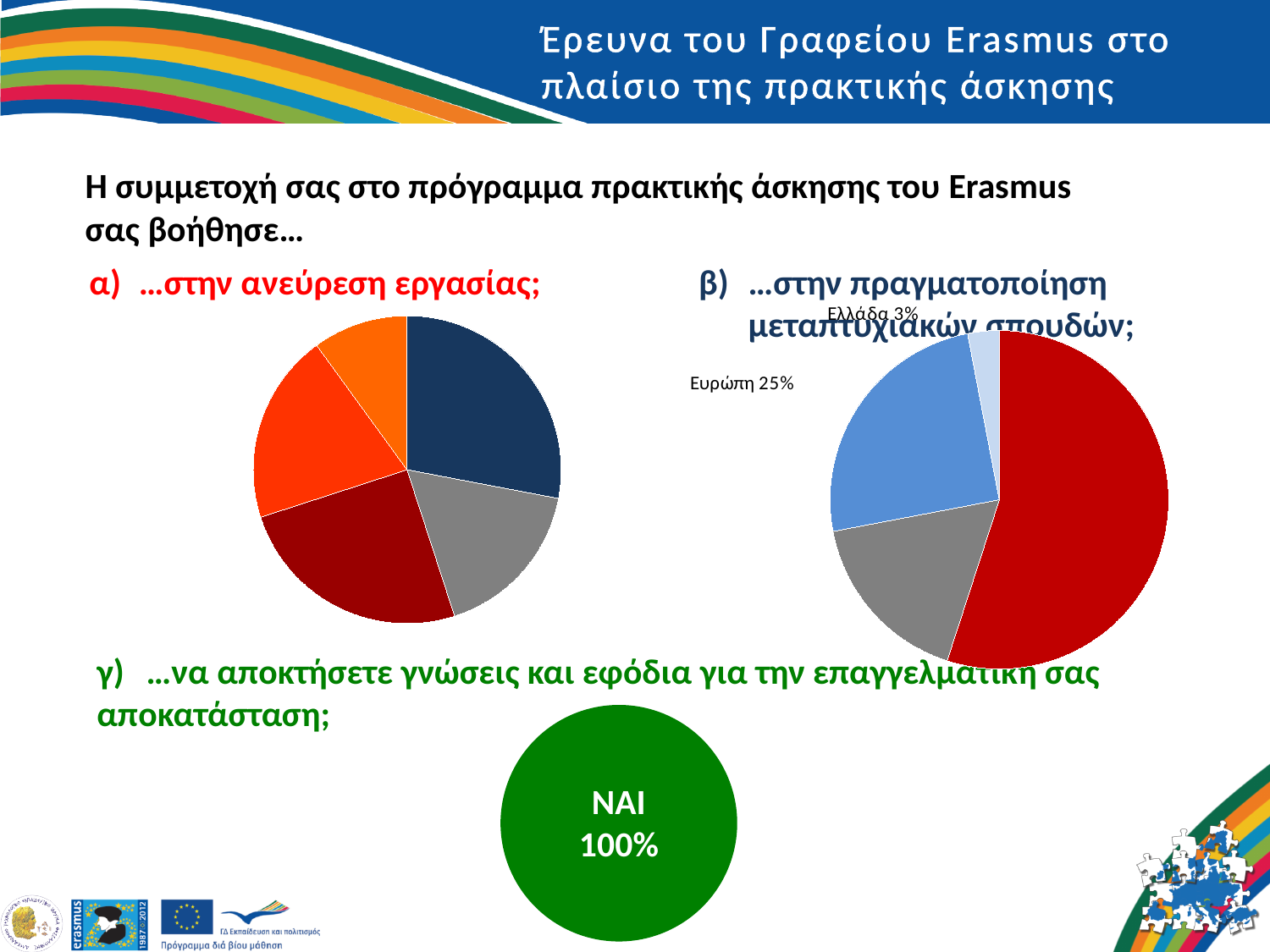
How many slices does the pie chart under "α) …στην ανεύρεση εργασίας;" have? 5 In the pie chart under "β) …στην πραγματοποίηση μεταπτυχιακών σπουδών;", what share is labelled for Ελλάδα? 3% In the pie chart under "β) …στην πραγματοποίηση μεταπτυχιακών σπουδών;", which labelled slice is larger, Ευρώπη or Ελλάδα? Ευρώπη How many slices does the pie chart under "β) …στην πραγματοποίηση μεταπτυχιακών σπουδών;" have? 4 What kind of chart is shown under "α) …στην ανεύρεση εργασίας;"? pie chart What text is shown inside the green circle under "γ) …να αποκτήσετε γνώσεις και εφόδια για την επαγγελματική σας αποκατάσταση;"? ΝΑΙ 100% In the pie chart under "β) …στην πραγματοποίηση μεταπτυχιακών σπουδών;", which labelled slice is the smallest? Ελλάδα What colour is the largest slice in the pie chart under "β) …στην πραγματοποίηση μεταπτυχιακών σπουδών;"? red In the pie chart under "β) …στην πραγματοποίηση μεταπτυχιακών σπουδών;", what share is labelled for Ευρώπη? 25% In the pie chart under "β) …στην πραγματοποίηση μεταπτυχιακών σπουδών;", what is the difference between the Ευρώπη share and the Ελλάδα share? 22%